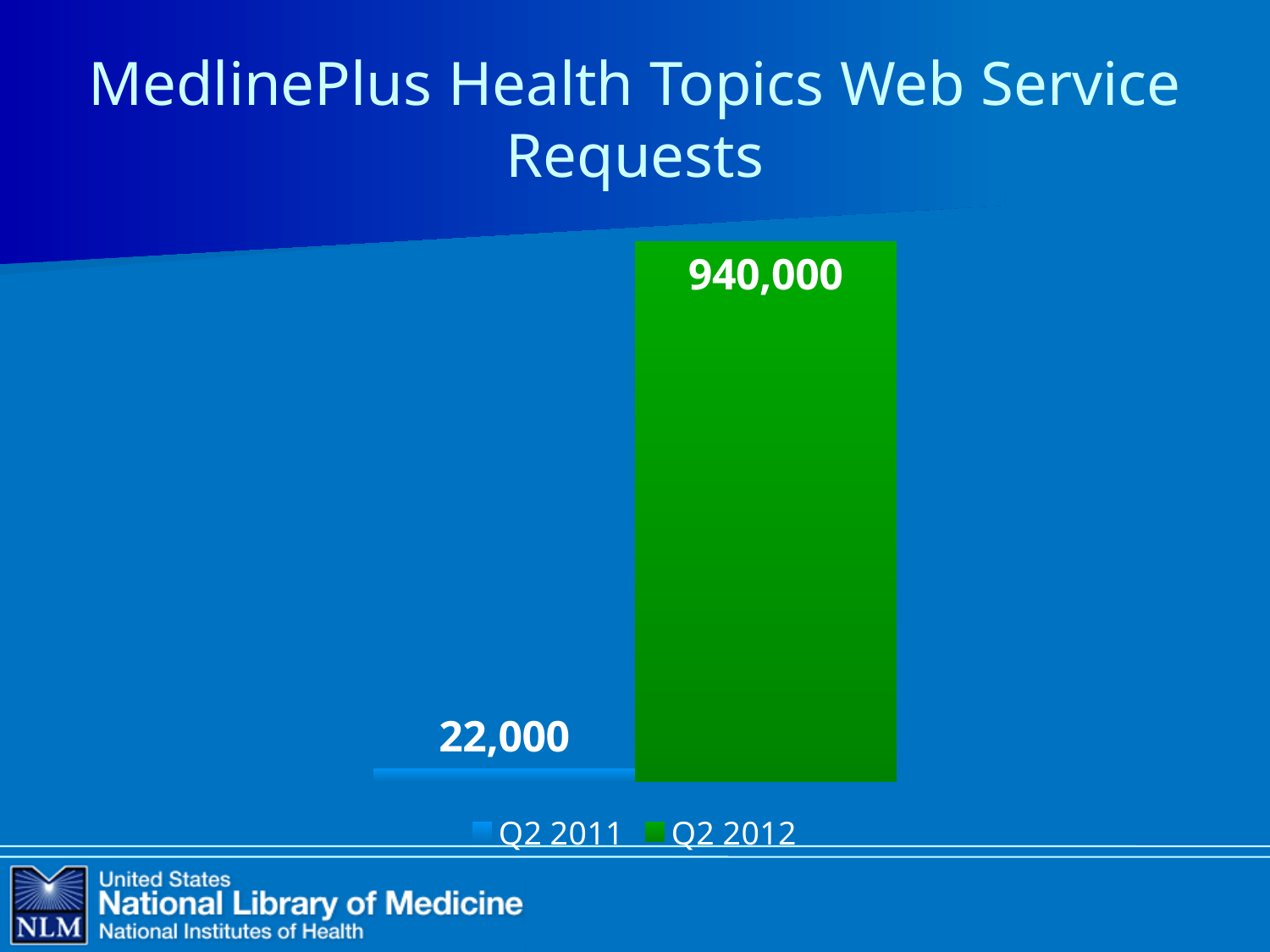
How many series does the legend list? 2 What is the value for Q2 2011? 22,000 What is the value for Q2 2012? 940,000 Which series has the lowest value? Q2 2011 Which is larger, the value for Q2 2011 or the value for Q2 2012? Q2 2012 How many bars are plotted on the chart? 2 What is the title of the slide? MedlinePlus Health Topics Web Service Requests Which series has the highest value? Q2 2012 What kind of chart is shown on the slide? Bar chart What is the difference between the Q2 2012 and Q2 2011 values? 918,000 What colour is the Q2 2012 bar? Green